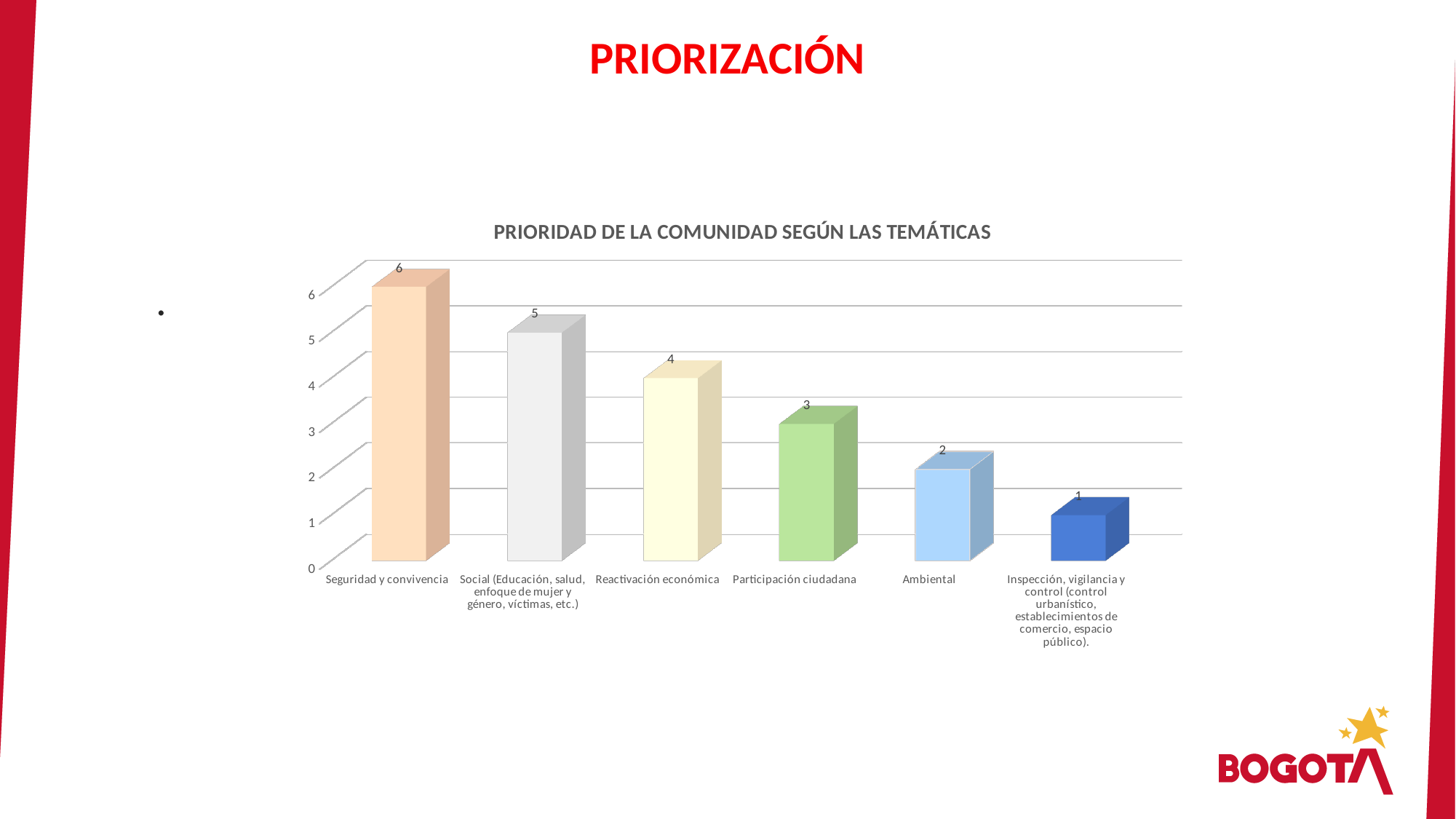
What is the value for Participación ciudadana? 3 Do the values rise or fall from left to right along the x axis? Fall How many categories are shown in the chart? 6 What is the value for Seguridad y convivencia? 6 Which is larger, the value for Social (Educación, salud, enfoque de mujer y género, víctimas, etc.) or the value for Reactivación económica? Social (Educación, salud, enfoque de mujer y género, víctimas, etc.) Which category has the highest value? Seguridad y convivencia What is the value for Reactivación económica? 4 Which category has the lowest value? Inspección, vigilancia y control (control urbanístico, establecimientos de comercio, espacio público). What kind of chart is shown on the slide? Bar chart What is the difference between the values for Seguridad y convivencia and Ambiental? 4 What is the value for Ambiental? 2 What is the title of the chart? PRIORIDAD DE LA COMUNIDAD SEGÚN LAS TEMÁTICAS